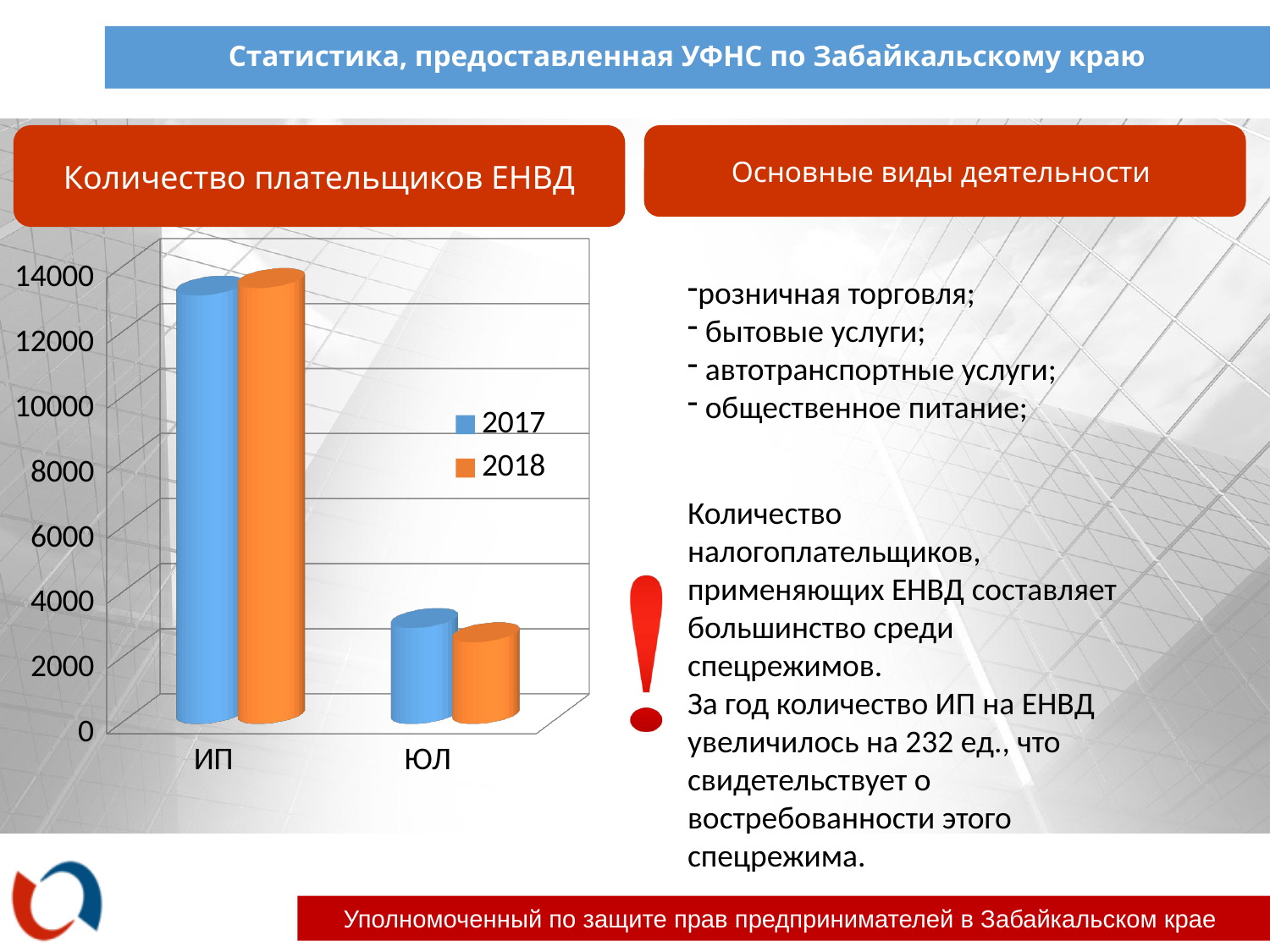
Is the 2018 value for ЮЛ greater or less than 4000? less What kind of chart is shown under the heading "Количество плательщиков ЕНВД"? bar chart How many categories are shown on the x axis of the chart? 2 Is the 2018 value for ИП greater or less than 12000? greater Which category has the highest values in the chart? ИП Which series are listed in the chart legend? 2017 and 2018 Is the 2017 value for ЮЛ greater or less than 4000? less Do the values rise or fall moving from ИП to ЮЛ along the x axis? fall Which category has the lowest values in the chart? ЮЛ For 2017, which category has the larger value, ИП or ЮЛ? ИП How many series does the chart legend list? 2